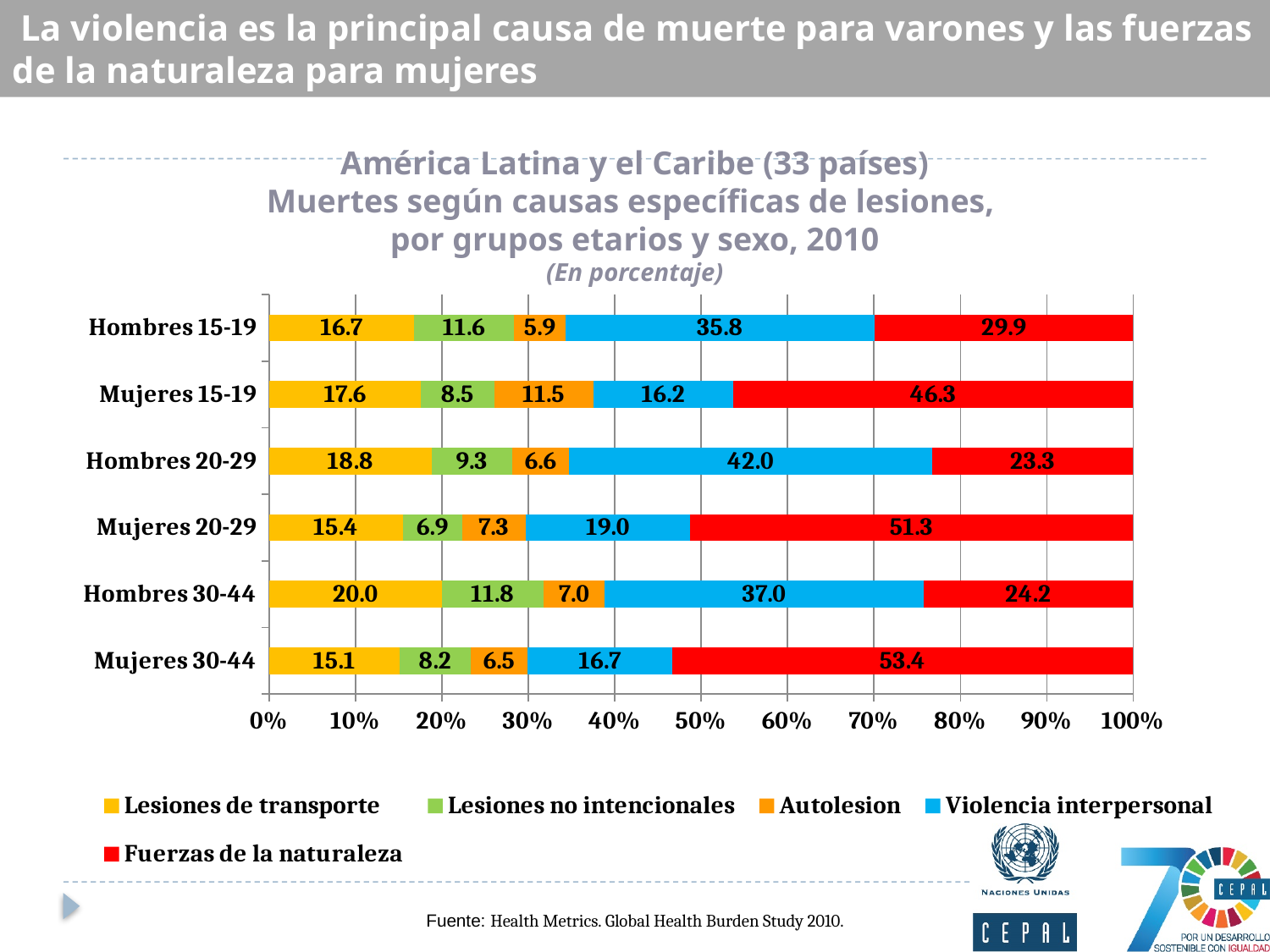
What kind of chart is shown on the slide? Stacked bar chart Which has the larger Lesiones de transporte value, Hombres 30-44 or Mujeres 20-29? Hombres 30-44 What is the value for Fuerzas de la naturaleza for Mujeres 30-44? 53.4 Which group has the highest value for Lesiones de transporte? Hombres 30-44 Which group has the lowest value for Autolesion? Hombres 15-19 What is the value for Violencia interpersonal for Hombres 20-29? 42.0 What is the value for Lesiones no intencionales for Hombres 30-44? 11.8 Which group has the highest value for Fuerzas de la naturaleza? Mujeres 30-44 How many age-sex groups are shown on the chart? 6 What is the difference between the Violencia interpersonal values for Hombres 15-19 and Mujeres 15-19? 19.6 What colour represents Violencia interpersonal in the chart? Blue How many series does the legend list? 5